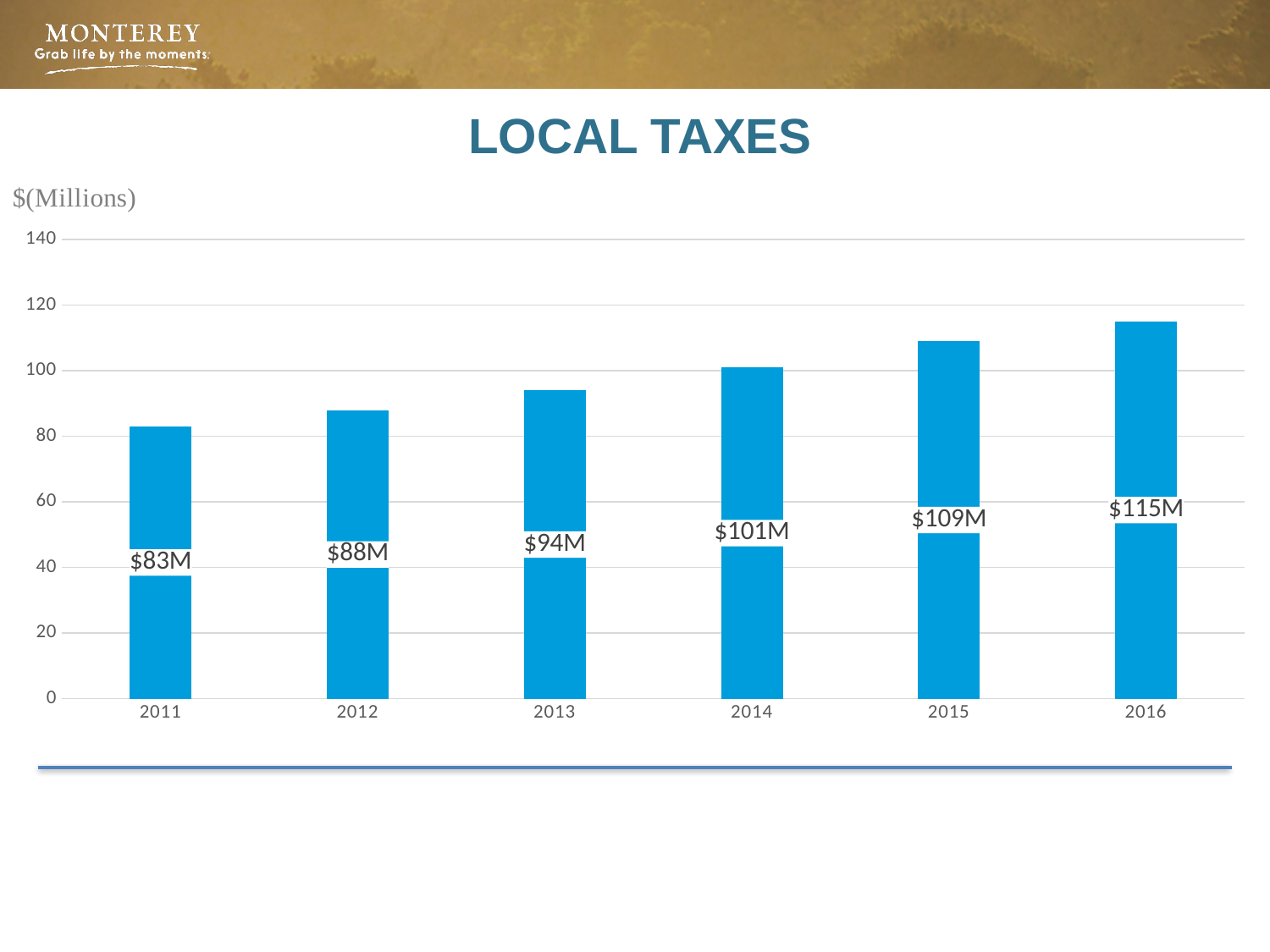
How many years are shown on the chart? 6 What is the difference between the values for 2015 and 2014? $8M Is the value for 2015 greater or less than 100? greater What is the value for 2011? $83M Which year has the highest local taxes? 2016 What is the value for 2016? $115M What is the value for 2014? $101M What kind of chart is shown on the slide? bar chart Which year has the lowest local taxes? 2011 What is the difference between the values for 2016 and 2011? $32M Do the values rise or fall from 2011 to 2016? rise Which is larger, the value for 2013 or the value for 2012? 2013